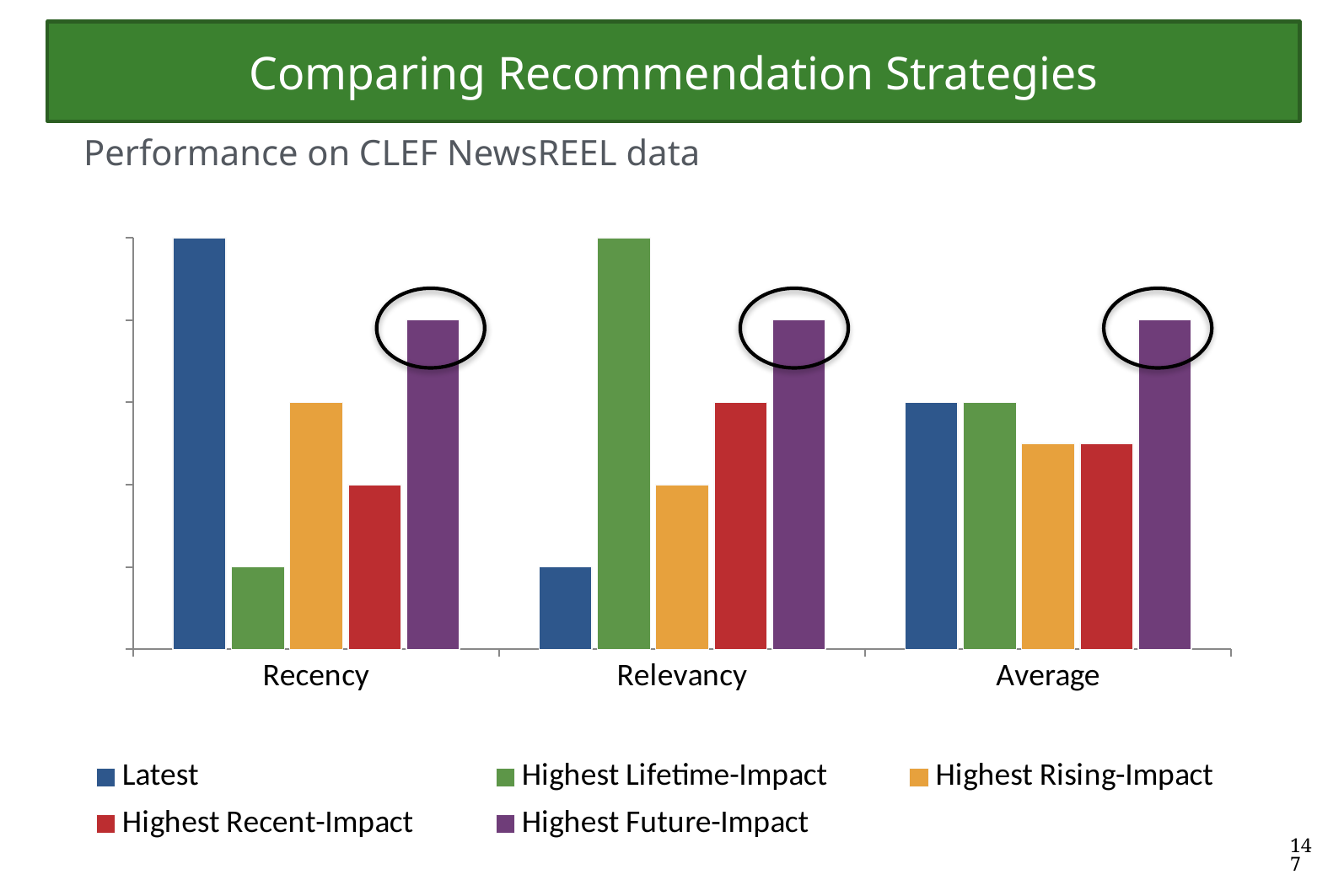
Which series has the highest value in the Recency category? Latest Which series has the highest value in the Average category? Highest Future-Impact In the Recency category, which is larger: Highest Rising-Impact or Highest Recent-Impact? Highest Rising-Impact Which series has the lowest value in the Recency category? Highest Lifetime-Impact Which series has the highest value in the Relevancy category? Highest Lifetime-Impact In the Relevancy category, which is larger: Highest Recent-Impact or Highest Rising-Impact? Highest Recent-Impact What kind of chart is shown on the slide? bar chart Which series has the lowest value in the Relevancy category? Latest How many series does the chart's legend list? 5 How many categories are shown on the x axis of the chart? 3 Which series is circled in every category of the chart? Highest Future-Impact What colour represents the Highest Rising-Impact series in the chart? orange